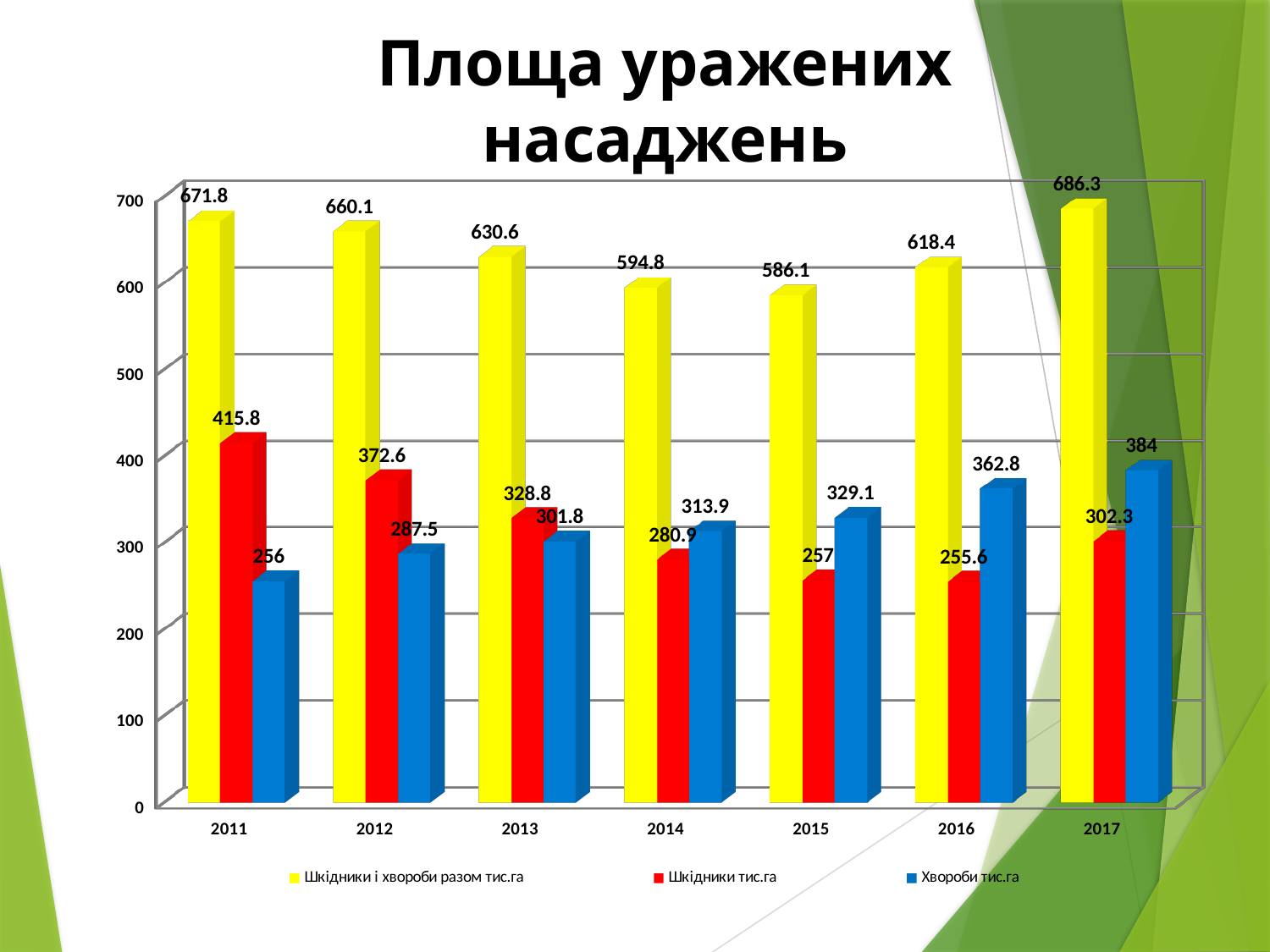
What is the value for Хвороби тис.га in 2014? 313.9 How many series does the legend list? 3 Which is larger in 2013: Шкідники тис.га or Хвороби тис.га? Шкідники тис.га What colour represents Шкідники тис.га in the chart? Red Does the value for Хвороби тис.га rise or fall from 2011 to 2017? Rises In which year is the value for Хвороби тис.га the highest? 2017 What is the value for Шкідники і хвороби разом тис.га in 2017? 686.3 What is the difference between the Шкідники тис.га values for 2011 and 2012? 43.2 What kind of chart is shown on the slide? Bar chart What is the value for Шкідники тис.га in 2011? 415.8 How many years are shown on the x axis? 7 In which year is the value for Шкідники і хвороби разом тис.га the lowest? 2015